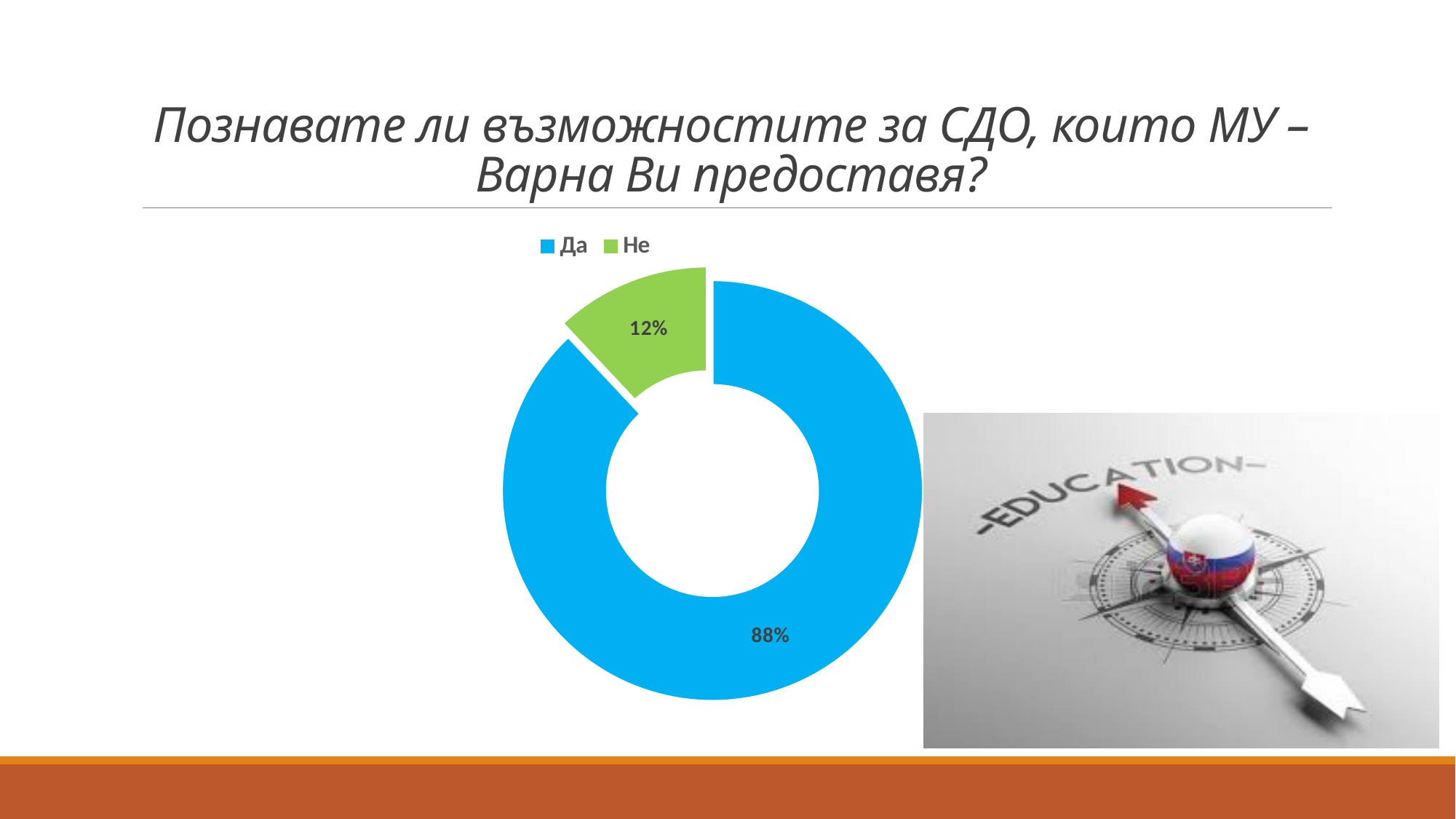
What percentage of respondents answered "Да"? 88% What colour is the "Не" slice? Green What percentage of respondents answered "Не"? 12% Which answer has the largest share of the chart? Да What colour is the "Да" slice? Blue Which answer has the smallest share of the chart? Не How many categories does the chart show? 2 What is the difference in percentage points between the "Да" and "Не" shares? 76 What kind of chart is shown on the slide? Pie chart (doughnut) What share of the pie does the "Не" slice represent? 12% Which is larger, the share for "Да" or the share for "Не"? Да